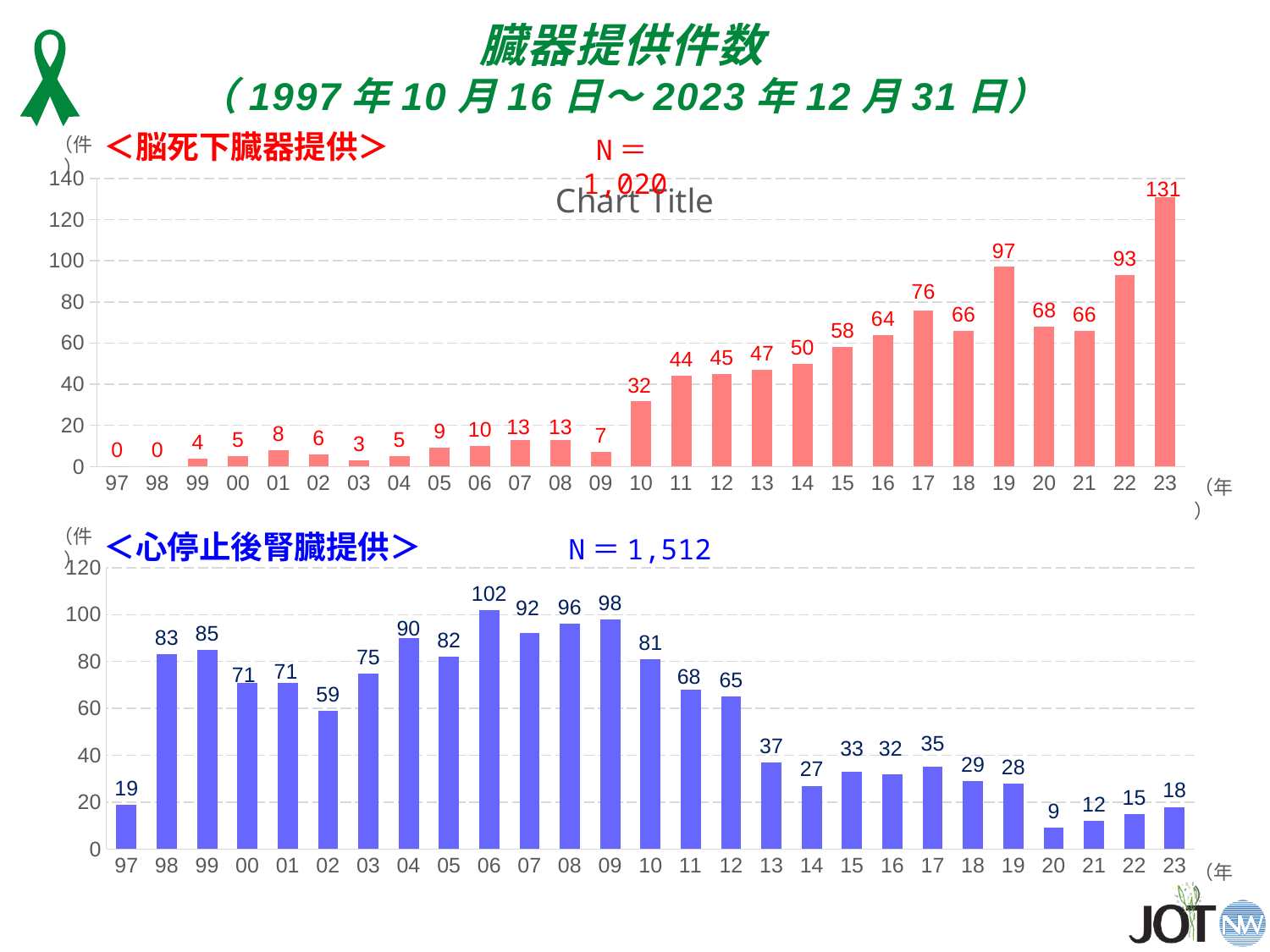
In the top chart (＜脳死下臓器提供＞), which year has the highest value? 23 What colour are the bars in the top chart (＜脳死下臓器提供＞)? red (pink) In the top chart (＜脳死下臓器提供＞), what is the value for 10? 32 How many years (categories) are shown on the x axis of the bottom chart (＜心停止後腎臓提供＞)? 27 In the top chart (＜脳死下臓器提供＞), what is the value for 23? 131 In the bottom chart (＜心停止後腎臓提供＞), what is the difference between the values for 98 and 97? 64 What kind of chart is the top chart (＜脳死下臓器提供＞)? bar chart In the bottom chart (＜心停止後腎臓提供＞), which year has the lowest value? 20 In the top chart (＜脳死下臓器提供＞), which is larger, the value for 19 or the value for 22? 19 In the bottom chart (＜心停止後腎臓提供＞), what is the value for 06? 102 What N value is shown for the bottom chart (＜心停止後腎臓提供＞)? N＝1,512 In the bottom chart (＜心停止後腎臓提供＞), do the values generally rise or fall from 13 to 20? fall